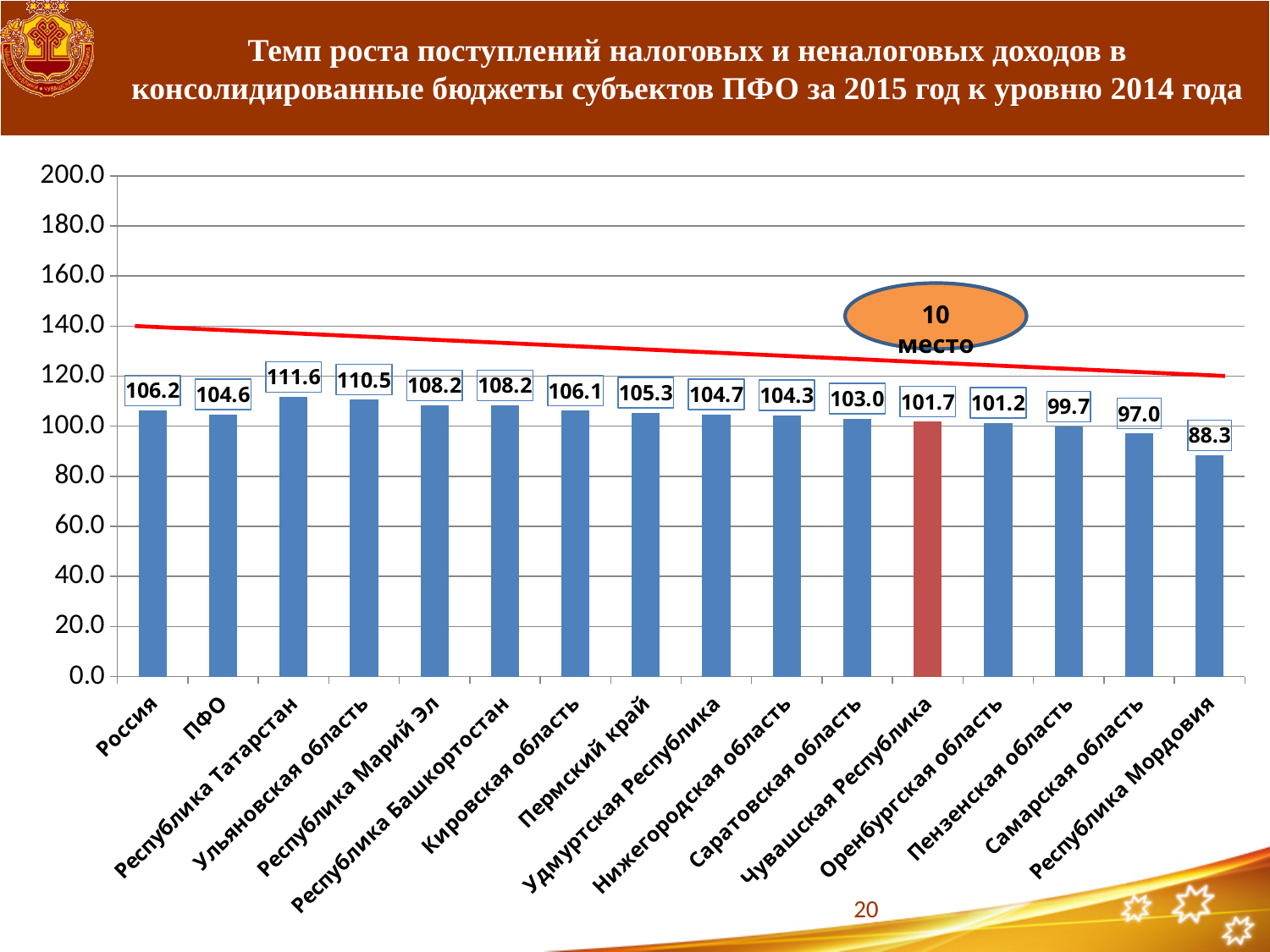
What is the value for Самарская область? 97.0 What is the difference between the values for Республика Татарстан and Республика Мордовия? 23.3 How many bars are shown in the chart? 16 Which bar is highlighted in a different colour (red) from the others? Чувашская Республика What kind of chart is shown on the slide? Bar chart What is the value for Россия? 106.2 Which category has the lowest value? Республика Мордовия Which is larger, the value for Ульяновская область or the value for Пензенская область? Ульяновская область Which category has the highest value? Республика Татарстан What is the value for Республика Татарстан? 111.6 What is the value for Чувашская Республика? 101.7 What is the difference between the values for Россия and Чувашская Республика? 4.5